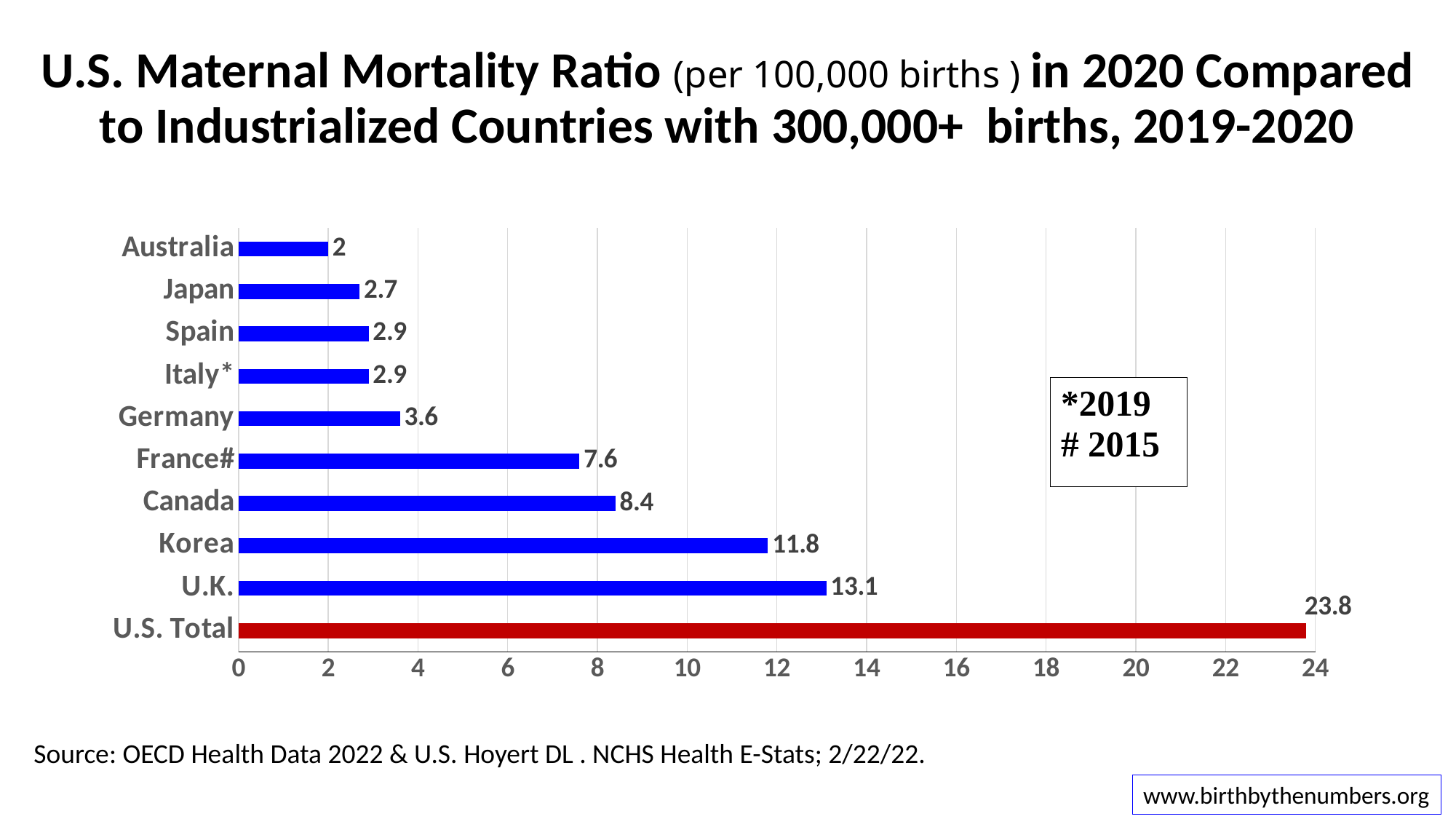
Which category has the highest value on the chart? U.S. Total What is the difference between the U.S. Total value and the U.K. value? 10.7 What is the value shown for Germany? 3.6 How many countries or categories are plotted on the chart? 10 What kind of chart is shown on the slide? Bar chart What is the difference between the Korea value and the Canada value? 3.4 Which country has the lowest maternal mortality ratio on the chart? Australia Which bar is coloured red rather than blue? U.S. Total Which has a higher value, France# or Japan? France# According to the note on the chart, what year does the asterisk (*) refer to? 2019 What is the value shown for Canada? 8.4 What is the maternal mortality ratio shown for the U.S. Total? 23.8